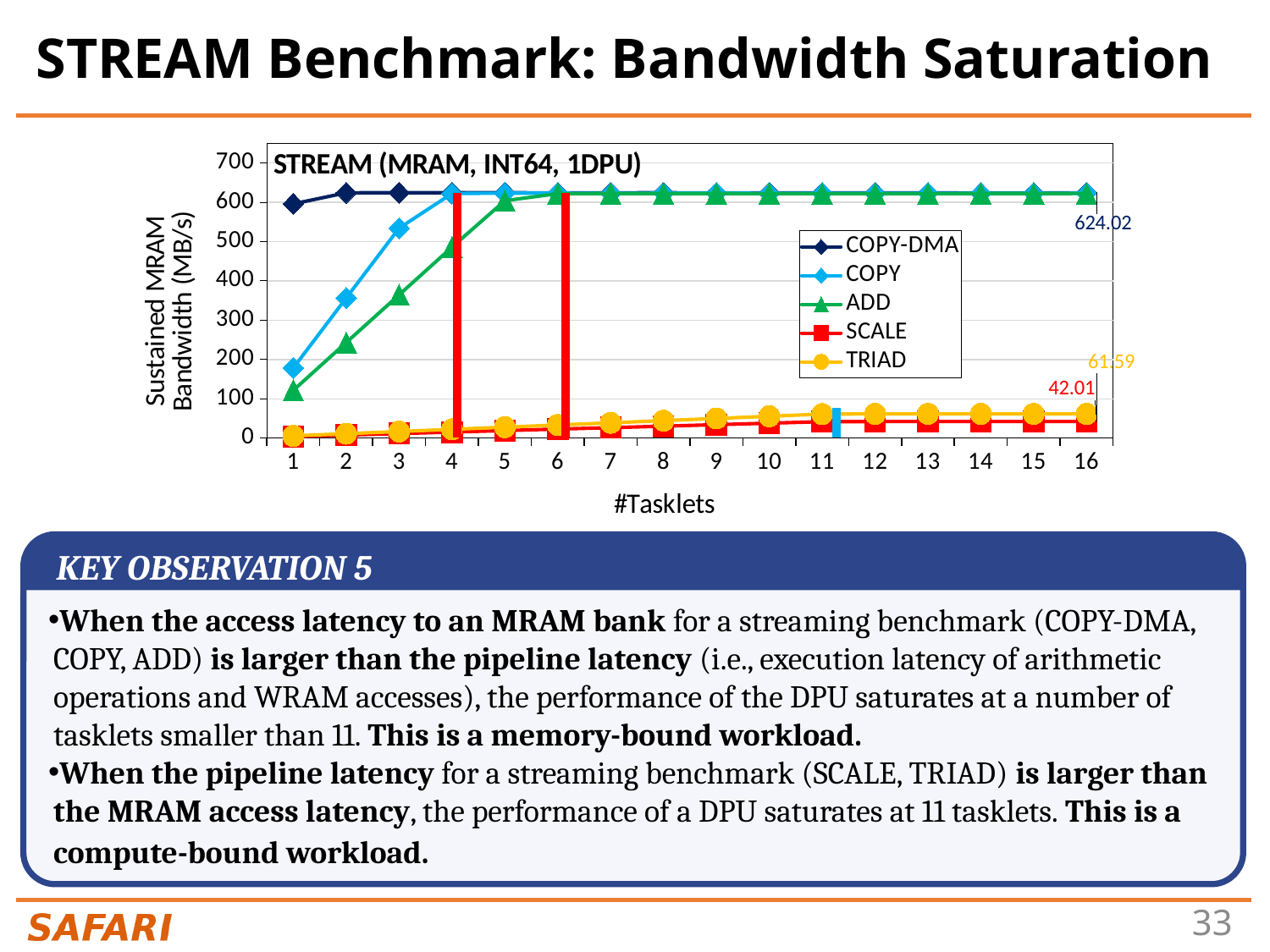
Is the value for COPY-DMA at 1 tasklet greater or less than 500? greater How many tasklet counts are plotted along the x axis? 16 What is the labelled value for COPY-DMA at 16 tasklets? 624.02 Among COPY-DMA, COPY and ADD, which series has the lowest value at 1 tasklet? ADD What is the title shown inside the chart area? STREAM (MRAM, INT64, 1DPU) How many series does the chart legend list? 5 What is the labelled value for TRIAD at 16 tasklets? 61.59 Is the value for COPY at 1 tasklet greater or less than 200? less What kind of chart is shown on the slide? line chart What is the labelled value for SCALE at 16 tasklets? 42.01 At 2 tasklets, which is larger: COPY or ADD? COPY What is the difference between the labelled TRIAD value (61.59) and the labelled SCALE value (42.01) at 16 tasklets? 19.58